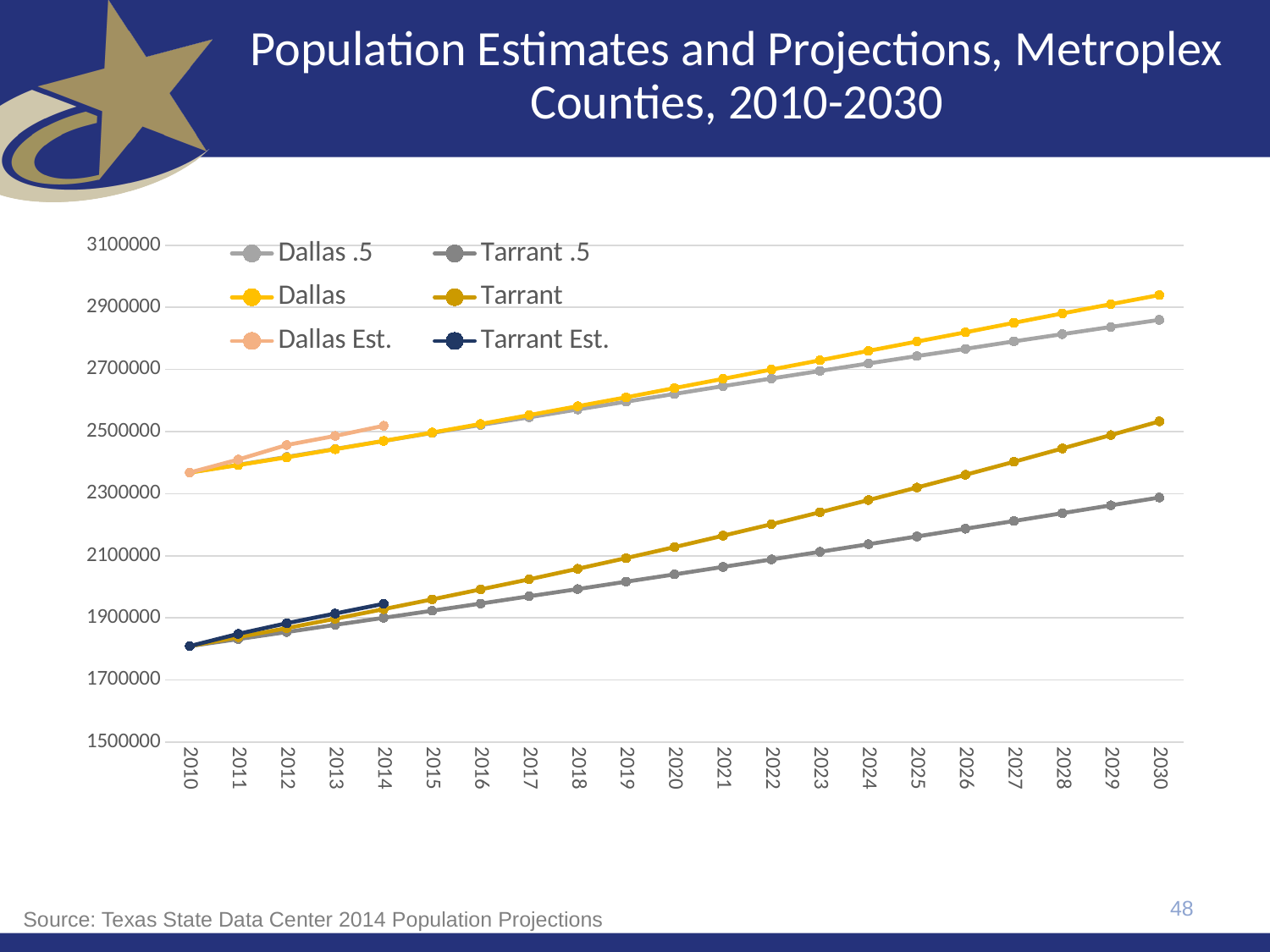
Is the value for Tarrant .5 in 2010 greater or less than 1900000? less Which series has the highest value in 2030? Dallas What kind of chart is shown on the slide? line chart Does the Dallas series rise or fall from 2010 to 2030? rise Is the value for Dallas .5 in 2030 greater or less than 2900000? less In 2025, which is larger, the Tarrant value or the Tarrant .5 value? Tarrant How many years are shown along the x axis? 21 Which series has the lowest value in 2030? Tarrant .5 What is the title of the chart on the slide? Population Estimates and Projections, Metroplex Counties, 2010-2030 In 2030, which is larger, the Dallas value or the Tarrant value? Dallas Is the value for Dallas in 2030 greater or less than 2700000? greater How many series does the legend list? 6